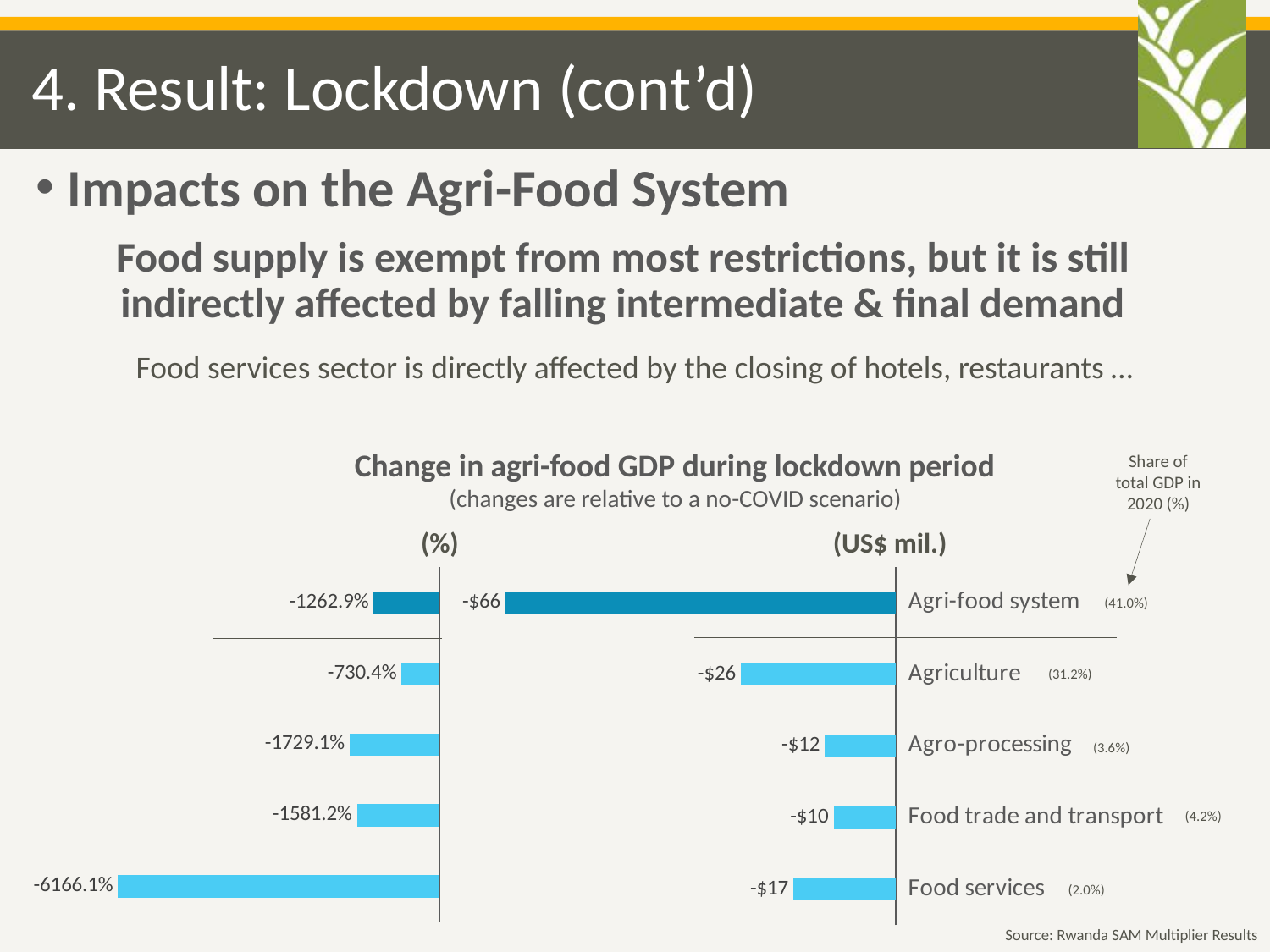
What share of total GDP in 2020 does Agriculture account for, according to the chart? 31.2% What is the title of the chart on the slide? Change in agri-food GDP during lockdown period In the (US$ mil.) chart, which category has the smallest decline in absolute terms? Food trade and transport In the (US$ mil.) chart, what is the difference between the values for Agriculture and Food services? $9 In the (%) chart, what is the value for Agriculture? -730.4% In the (US$ mil.) chart, which has a larger decline, Agro-processing or Food services? Food services In the (US$ mil.) chart, what is the value for Agri-food system? -$66 How many categories are shown in each chart? 5 In the (US$ mil.) chart, what is the value for Agro-processing? -$12 What type of chart is used to show the change in agri-food GDP? Bar chart In the (%) chart, what is the value for Food services? -6166.1% In the (%) chart, which category shows the largest percentage decline? Food services